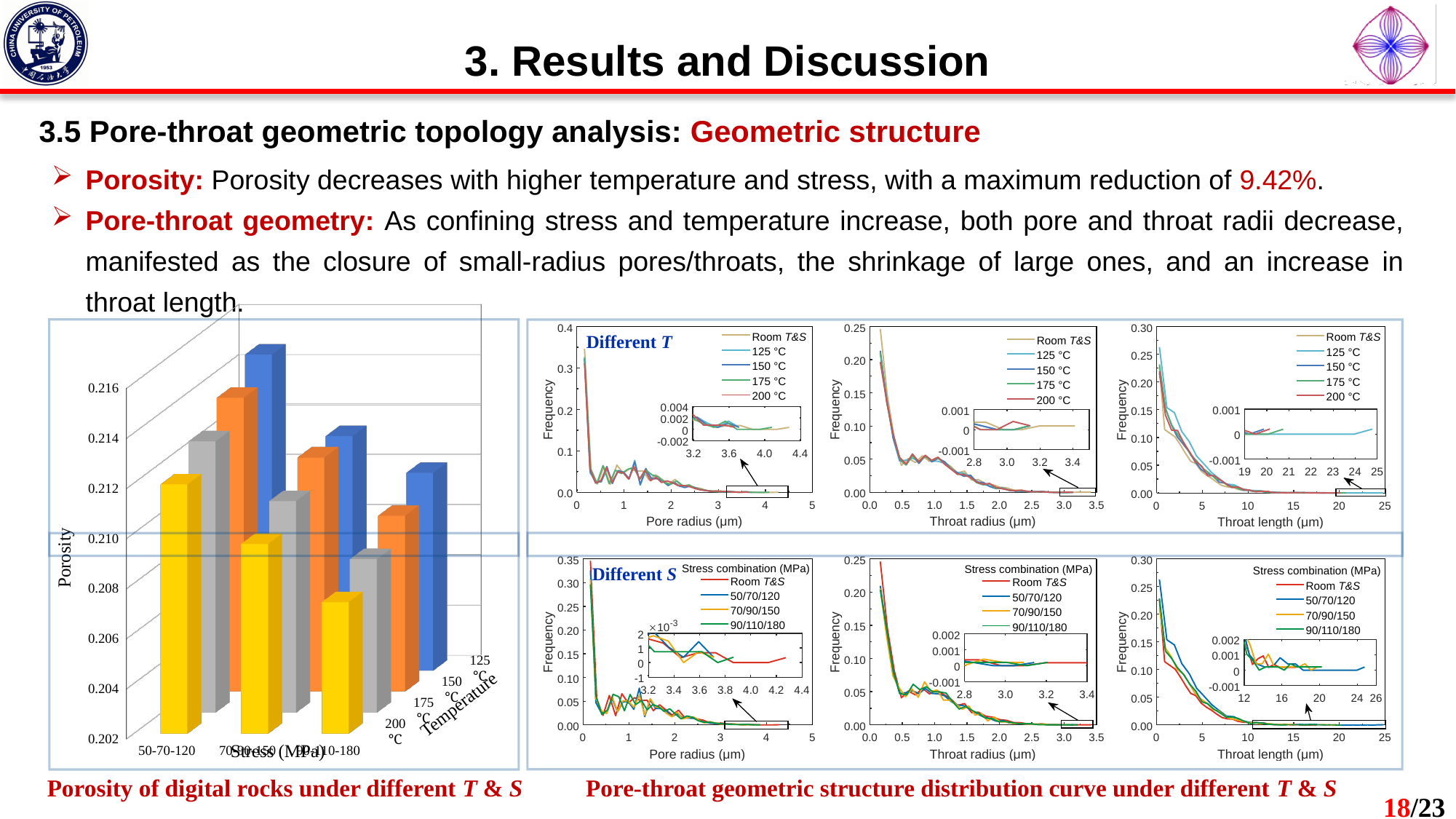
In the 'Different S' pore radius chart (bottom left of the right panel), how many series does the legend list? 4 In the porosity bar chart, which stress combination has the highest porosity for the 125 °C series? 50-70-120 In the porosity bar chart, how many temperature levels are shown along the temperature axis? 4 What is the y-axis label shared by the six line charts on the right of the slide? Frequency In the porosity bar chart, how many stress combinations are shown along the stress axis? 3 In the 'Different T' throat length chart (top right of the right panel), does frequency rise or fall as throat length increases from 0 to 25 µm? fall What kind of chart is the porosity chart on the left of the slide? bar chart In the 'Different T' pore radius chart (top left of the right panel), how many series does the legend list? 5 In the porosity bar chart, does porosity rise or fall as stress increases from 50-70-120 to 90-110-180 at 200 °C? fall What is the x-axis label of the middle chart in the 'Different S' row? Throat radius (µm) In the porosity bar chart, is the porosity at 90-110-180 and 200 °C greater or less than 0.210? less In the porosity bar chart, is the porosity at 50-70-120 and 125 °C greater or less than 0.214? greater